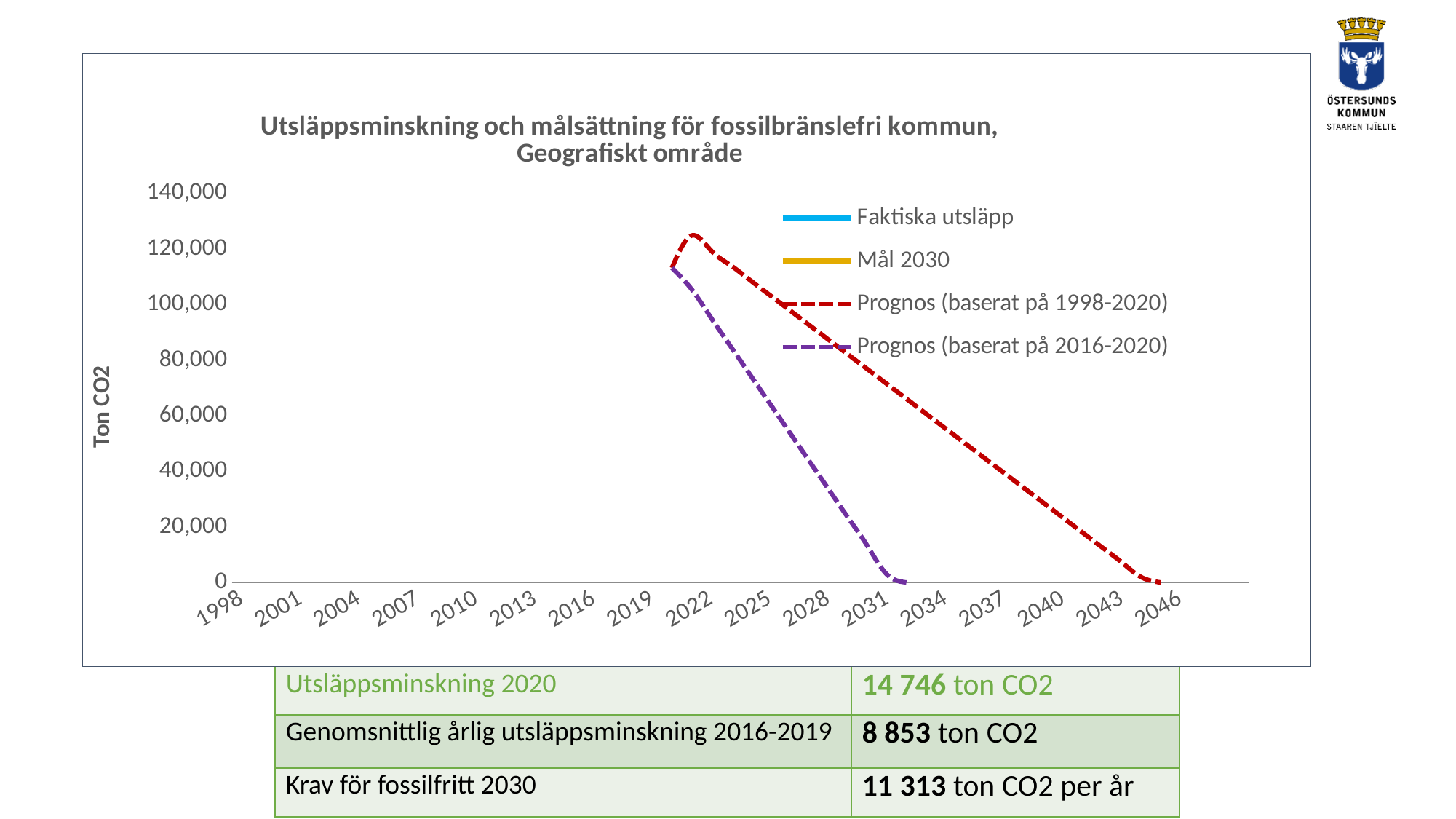
How many series does the chart legend list? 4 Which prognosis line reaches 0 earlier: 'Prognos (baserat på 1998-2020)' or 'Prognos (baserat på 2016-2020)'? Prognos (baserat på 2016-2020) At 2028, which line is higher: 'Prognos (baserat på 1998-2020)' or 'Prognos (baserat på 2016-2020)'? Prognos (baserat på 1998-2020) Is the value of 'Prognos (baserat på 1998-2020)' at 2031 greater or less than 60,000? greater Do the values of the 'Prognos (baserat på 1998-2020)' line rise or fall after 2022? fall How many year labels are shown on the x axis of the chart? 17 Is the value of 'Prognos (baserat på 2016-2020)' at 2028 greater or less than 60,000? less What is the label on the vertical axis of the chart? Ton CO2 Is the value of 'Prognos (baserat på 1998-2020)' at 2040 greater or less than 40,000? less What kind of chart is shown on the slide? line chart What is the title of the chart? Utsläppsminskning och målsättning för fossilbränslefri kommun, Geografiskt område Do the values of the 'Prognos (baserat på 2016-2020)' line rise or fall along the x axis? fall